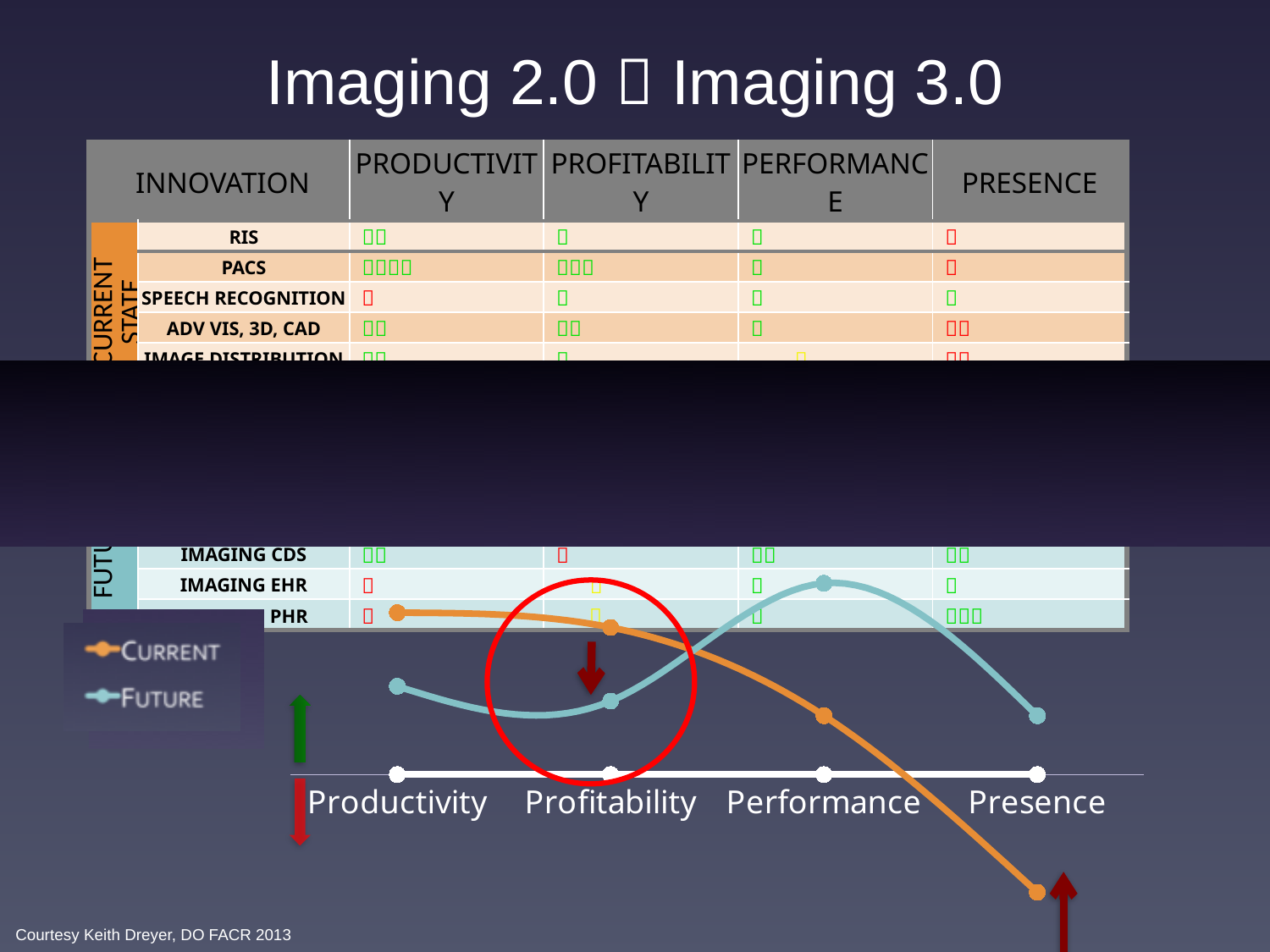
At Presence, which series is higher, Current or Future? Future At Profitability, which series is higher, Current or Future? Current What kind of chart is shown at the bottom of the slide? line chart At Productivity, which series is higher, Current or Future? Current Which category is the last one on the x axis of the line chart? Presence How many categories are shown on the x axis of the line chart? 4 Does the Current series rise or fall from Productivity to Presence? fall What are the two series named in the legend of the line chart? Current and Future At which category does the Future series reach its highest point? Performance At which category does the Current series reach its lowest point? Presence How many series does the legend of the line chart list? 2